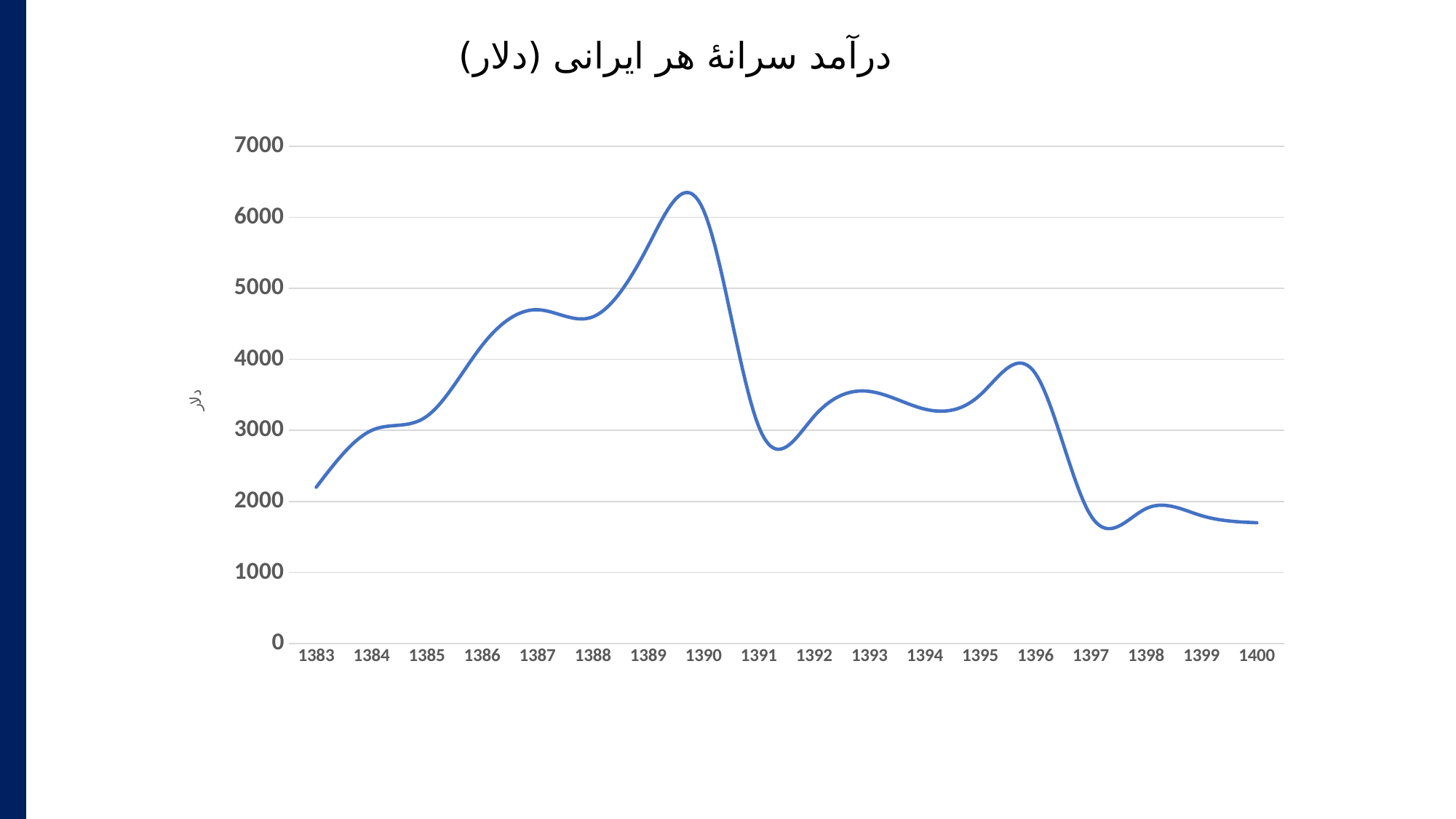
What kind of chart is shown on the slide? line chart Is the value for 1387 greater or less than 5000? less Is the value for 1397 greater or less than 2000? less Which year has the larger value, 1383 or 1400? 1383 Does the line rise or fall from 1383 to 1390? rise Is the value for 1390 greater or less than 6000? greater Which year has the larger value, 1390 or 1396? 1390 What is the title of the chart? درآمد سرانۀ هر ایرانی (دلار) How many years are plotted along the x axis? 18 In which year does the line reach its highest value? 1390